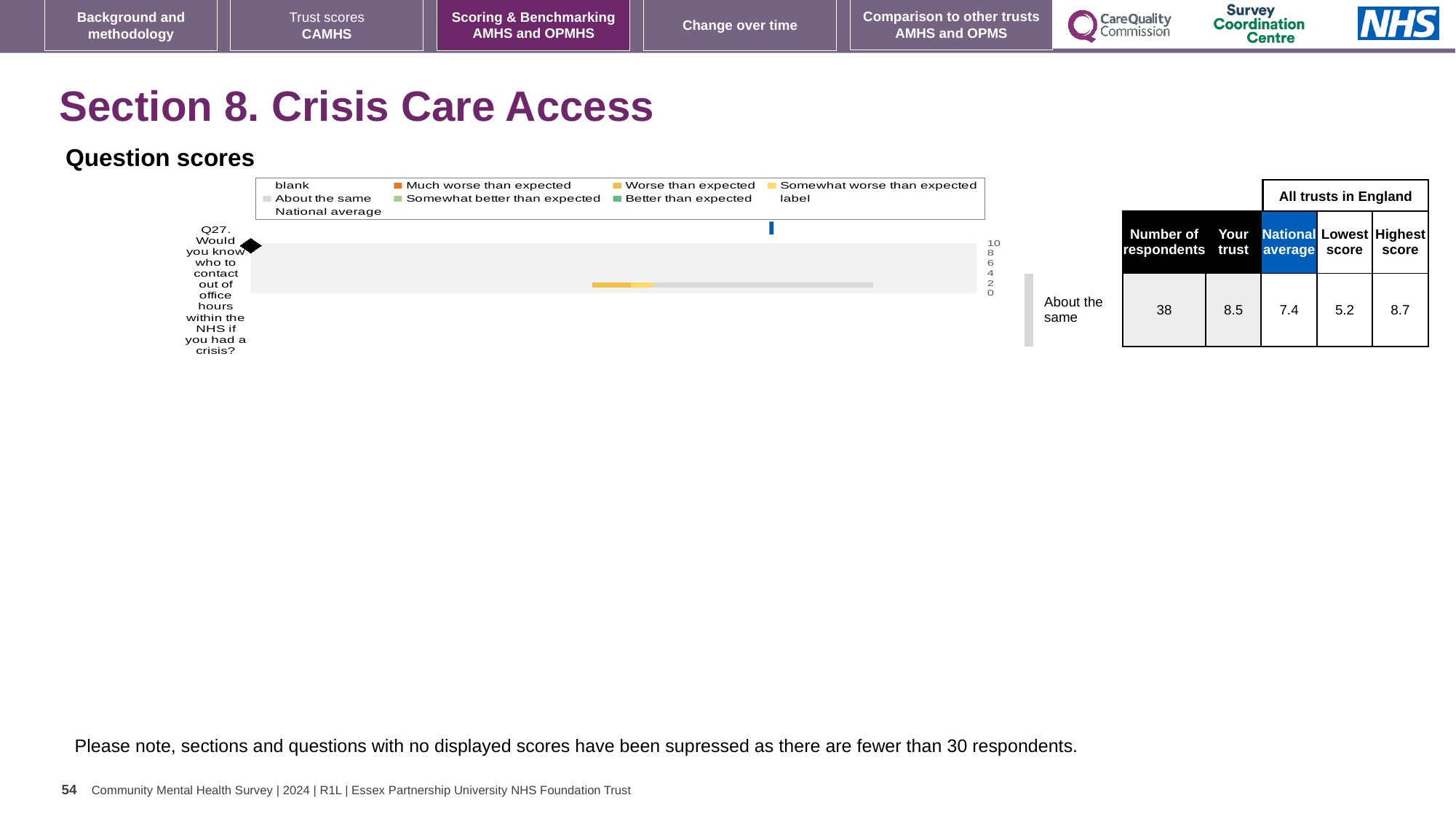
What is the number of respondents for Q27? 38 What is the 'Your trust' score for Q27? 8.5 Which question is plotted in the 'Question scores' chart? Q27. Would you know who to contact out of office hours within the NHS if you had a crisis? What is the highest score among all trusts in England for Q27? 8.7 Which is larger for Q27, the 'Your trust' score or the national average? Your trust What is the benchmark category shown next to the bar for Q27? About the same What is the national average score for Q27? 7.4 What is the difference between the 'Your trust' score and the national average for Q27? 1.1 What is the lowest score among all trusts in England for Q27? 5.2 What is the difference between the highest and lowest scores among all trusts in England for Q27? 3.5 How many questions are plotted in the 'Question scores' chart? 1 What type of chart is shown under 'Question scores'? bar chart